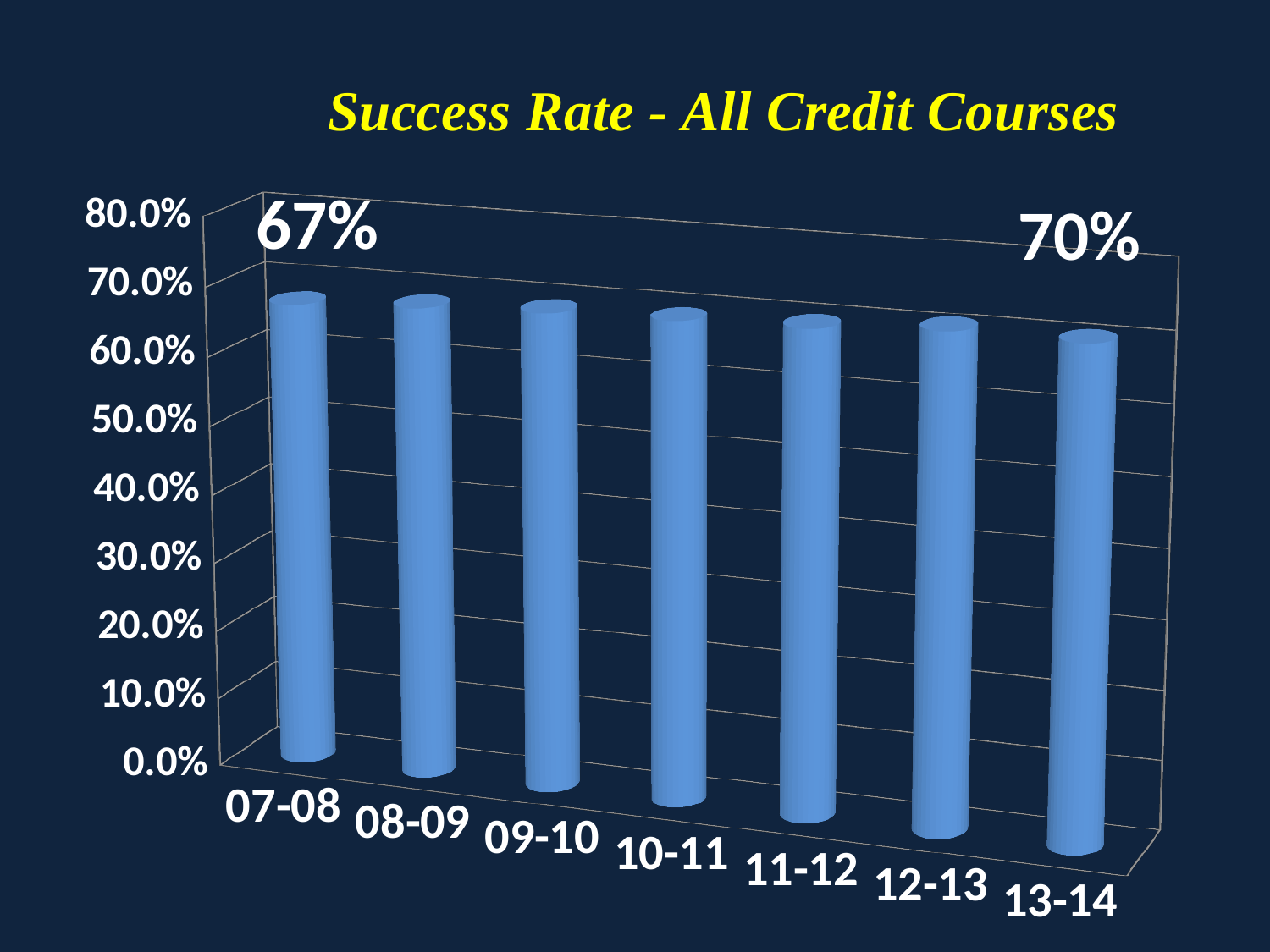
What colour are the bars in the chart? Blue Is the value for 10-11 greater or less than 50.0%? greater Is the value for 11-12 greater or less than 40.0%? greater What is the difference between the labelled success rates for 13-14 and 07-08? 3% What is the success rate shown for 13-14? 70% How many academic years are shown on the x axis? 7 What is the success rate shown for 07-08? 67% Is the value for 08-09 greater or less than 80.0%? less What is the highest value shown on the y axis? 80.0% What is the title of the chart? Success Rate - All Credit Courses Which has the higher labelled success rate, 07-08 or 13-14? 13-14 What kind of chart is shown on the slide? Bar chart